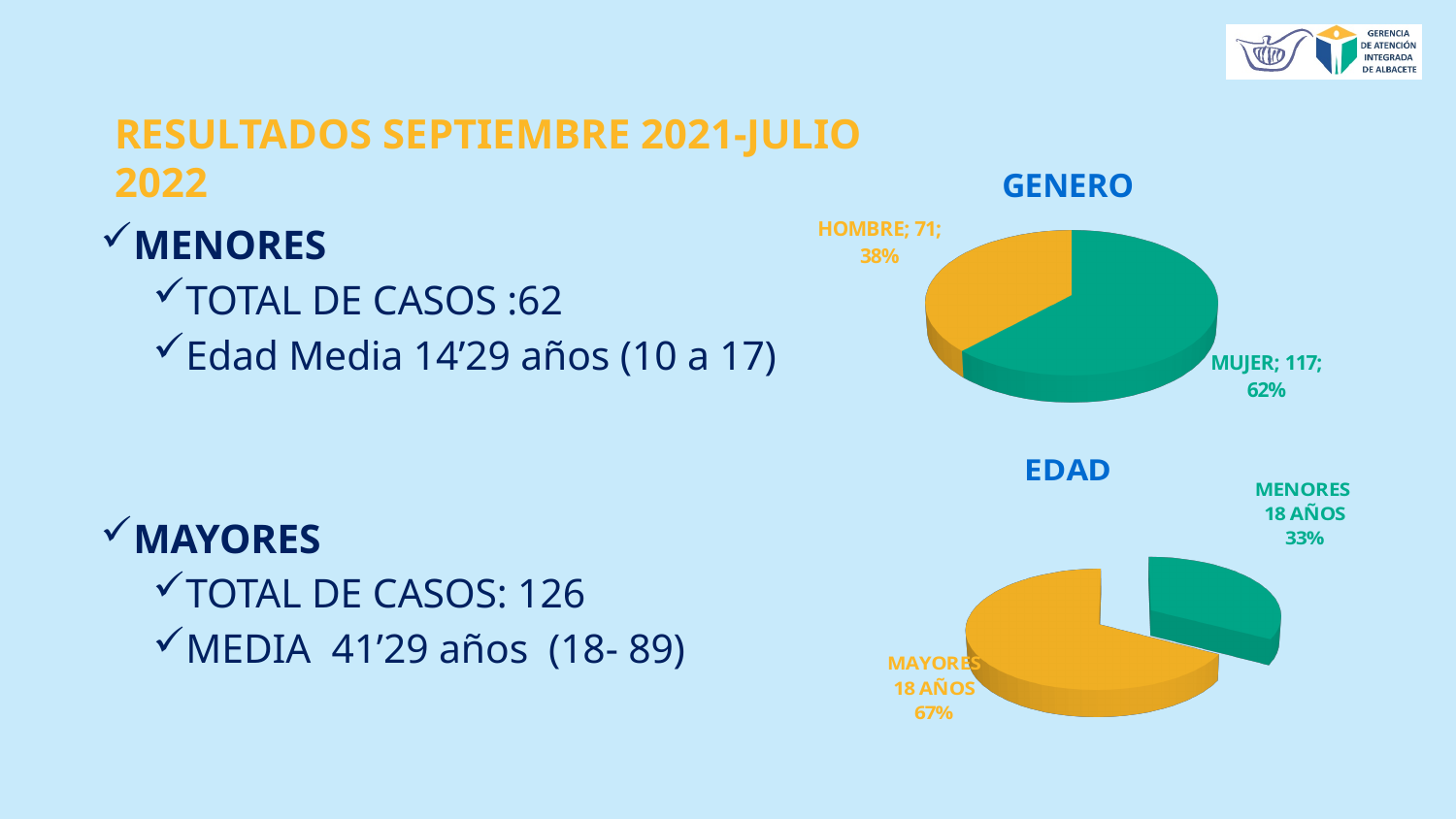
In the GENERO chart, how many cases are labelled MUJER? 117 What kind of chart is the EDAD chart? Pie chart In the EDAD chart, what colour is the MAYORES 18 AÑOS slice? Yellow/orange In the GENERO chart, what percentage share does the MUJER slice have? 62% In the EDAD chart, what percentage share does the MAYORES 18 AÑOS slice have? 67% In the EDAD chart, which category has the smaller slice? MENORES 18 AÑOS In the GENERO chart, which category has the larger slice? MUJER In the GENERO chart, how many slices does the pie have? 2 In the GENERO chart, what is the difference between the MUJER and HOMBRE counts? 46 In the GENERO chart, how many cases are labelled HOMBRE? 71 In the GENERO chart, what percentage share does the HOMBRE slice have? 38%